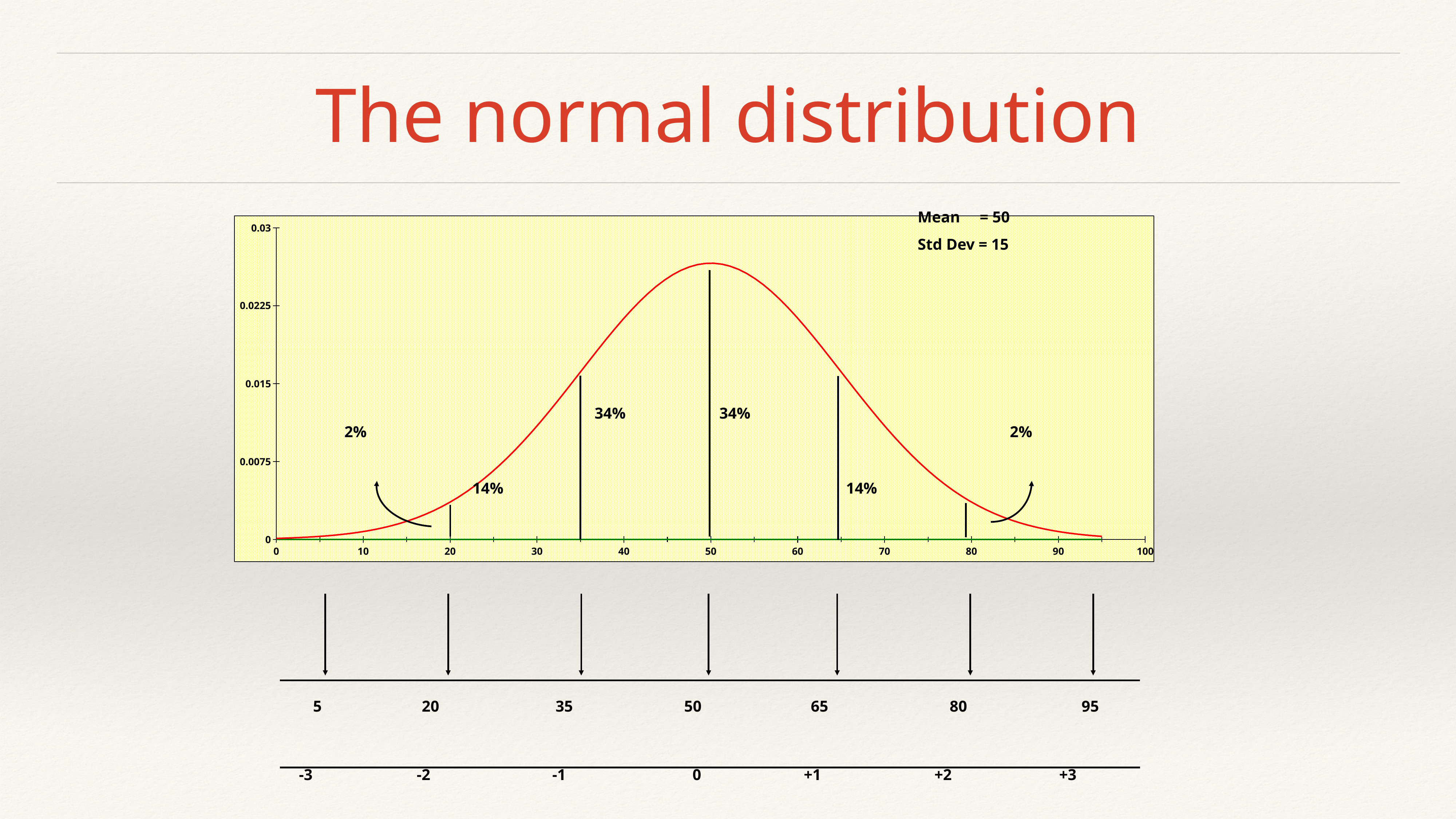
Is the peak of the curve greater or less than 0.0225 on the y axis? greater What percentage label is shown in the left tail of the curve, below 20 on the x axis? 2% What is the title of the slide containing the chart? The normal distribution What percentage label is shown between the vertical lines at 35 and 50 on the x axis? 34% What is the difference between the 34% label and the 14% label on the chart? 20% What percentage label is shown between the vertical lines at 20 and 35 on the x axis? 14% What mean value is stated on the chart? 50 At which x-axis value does the curve reach its highest point? 50 How many percentage labels are printed on the chart? 6 What standard deviation is stated on the chart? 15 What kind of chart is shown on the slide? line chart What is the combined percentage for the two regions between 35 and 65 on the x axis? 68%